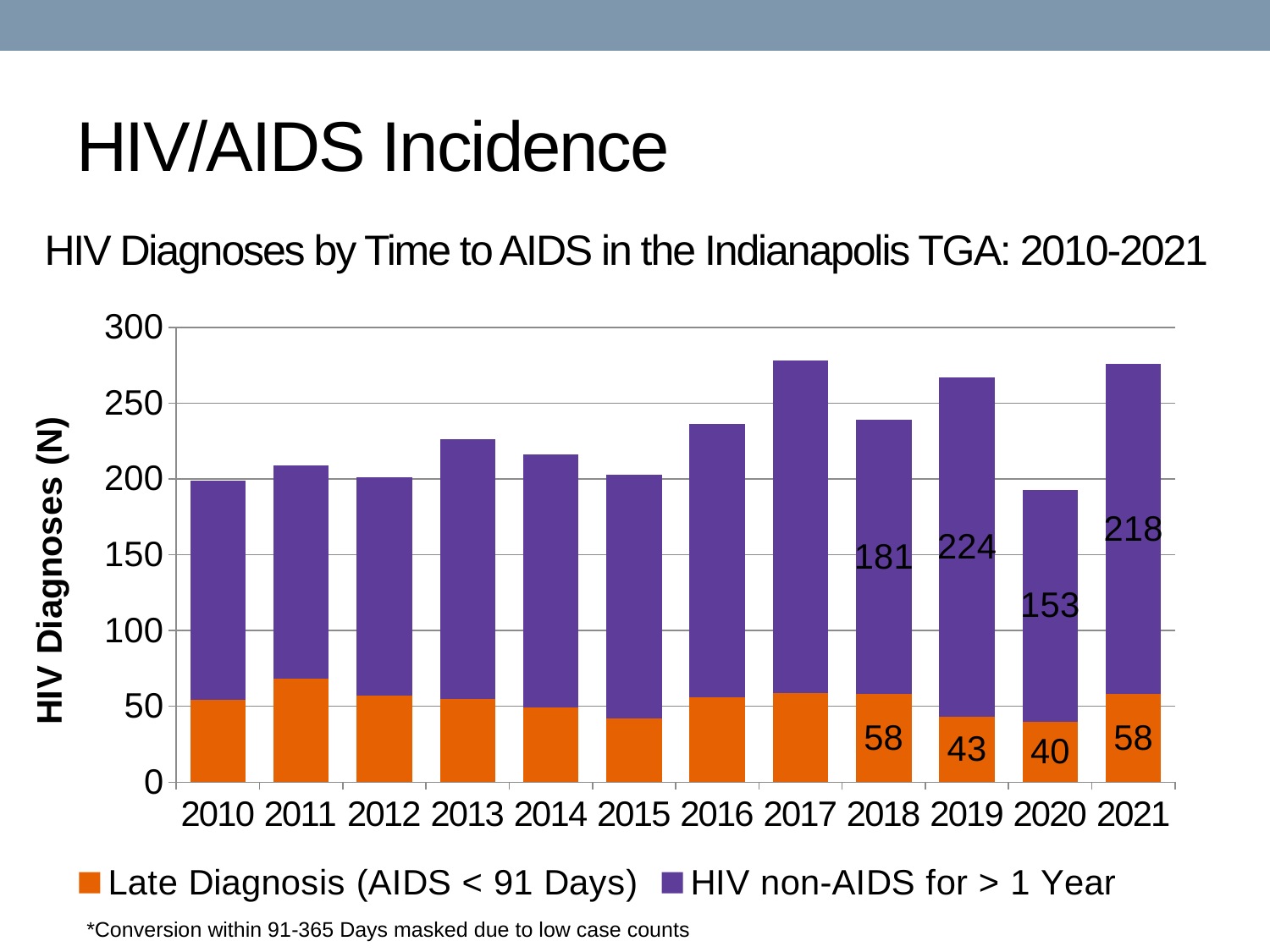
Which year has the lowest total HIV diagnoses? 2020 What is the value for HIV non-AIDS for > 1 Year in 2020? 153 What is the difference between the HIV non-AIDS for > 1 Year values in 2019 and 2020? 71 How many series does the legend list? 2 What is the total of the stacked bar for 2019? 267 Which is larger, the HIV non-AIDS for > 1 Year value in 2021 or in 2018? 2021 What kind of chart is shown on the slide? Stacked bar chart What is the value for Late Diagnosis (AIDS < 91 Days) in 2021? 58 What is the value for HIV non-AIDS for > 1 Year in 2018? 181 What is the value for Late Diagnosis (AIDS < 91 Days) in 2019? 43 Is the total HIV diagnoses for 2017 greater or less than 250? greater How many years are shown on the x axis? 12